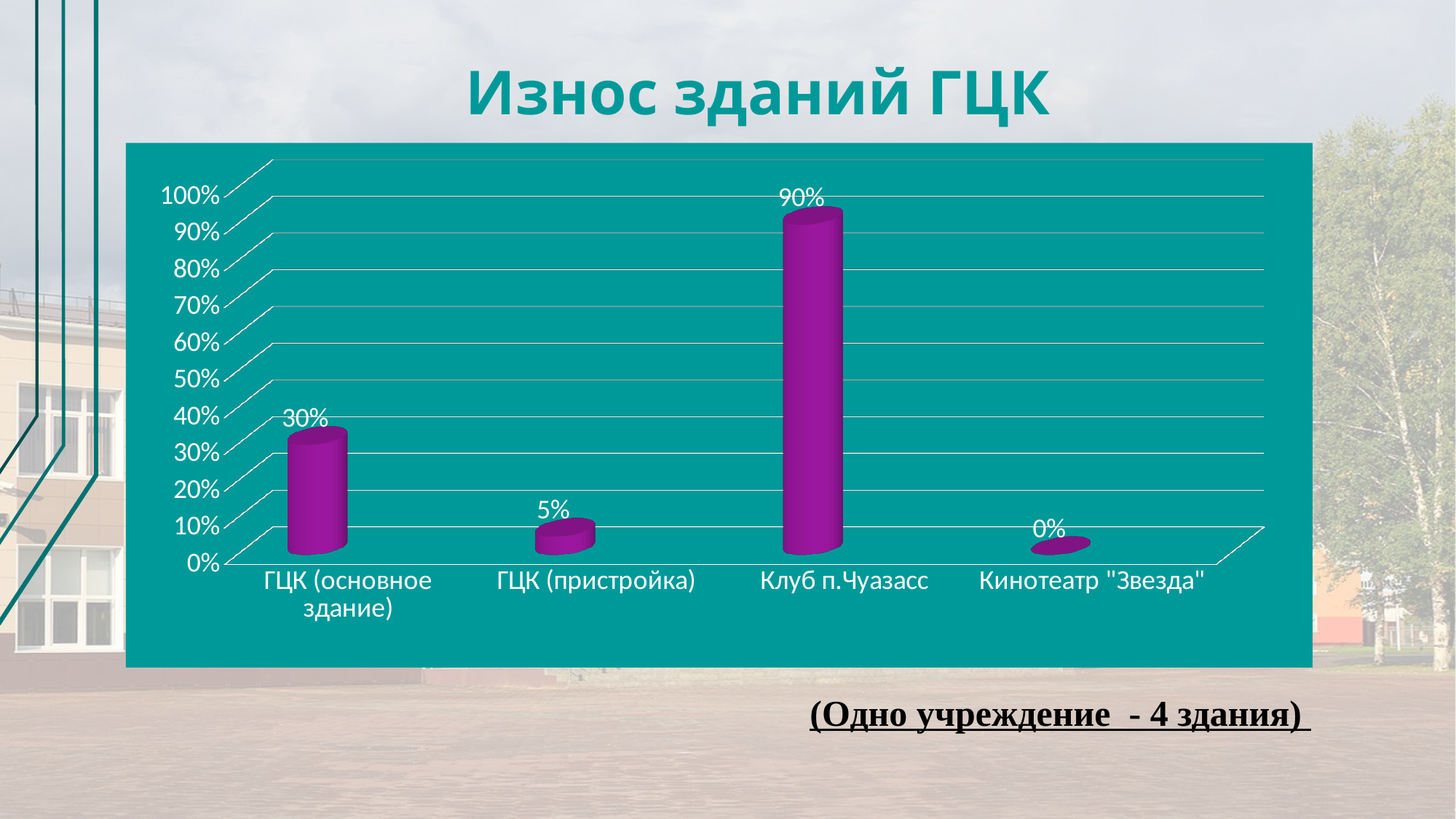
Which category has the lowest value? Кинотеатр "Звезда" What is the title of the chart? Износ зданий ГЦК How many categories are shown on the chart? 4 What is the value for Клуб п.Чуазасс? 90% Which is larger, the value for ГЦК (основное здание) or ГЦК (пристройка)? ГЦК (основное здание) Is the value for Клуб п.Чуазасс greater or less than 50%? greater What kind of chart is shown on the slide? bar chart What is the value for ГЦК (основное здание)? 30% What is the value for ГЦК (пристройка)? 5% Which category has the highest value? Клуб п.Чуазасс What is the difference between the values for Клуб п.Чуазасс and ГЦК (основное здание)? 60% What is the value for Кинотеатр "Звезда"? 0%